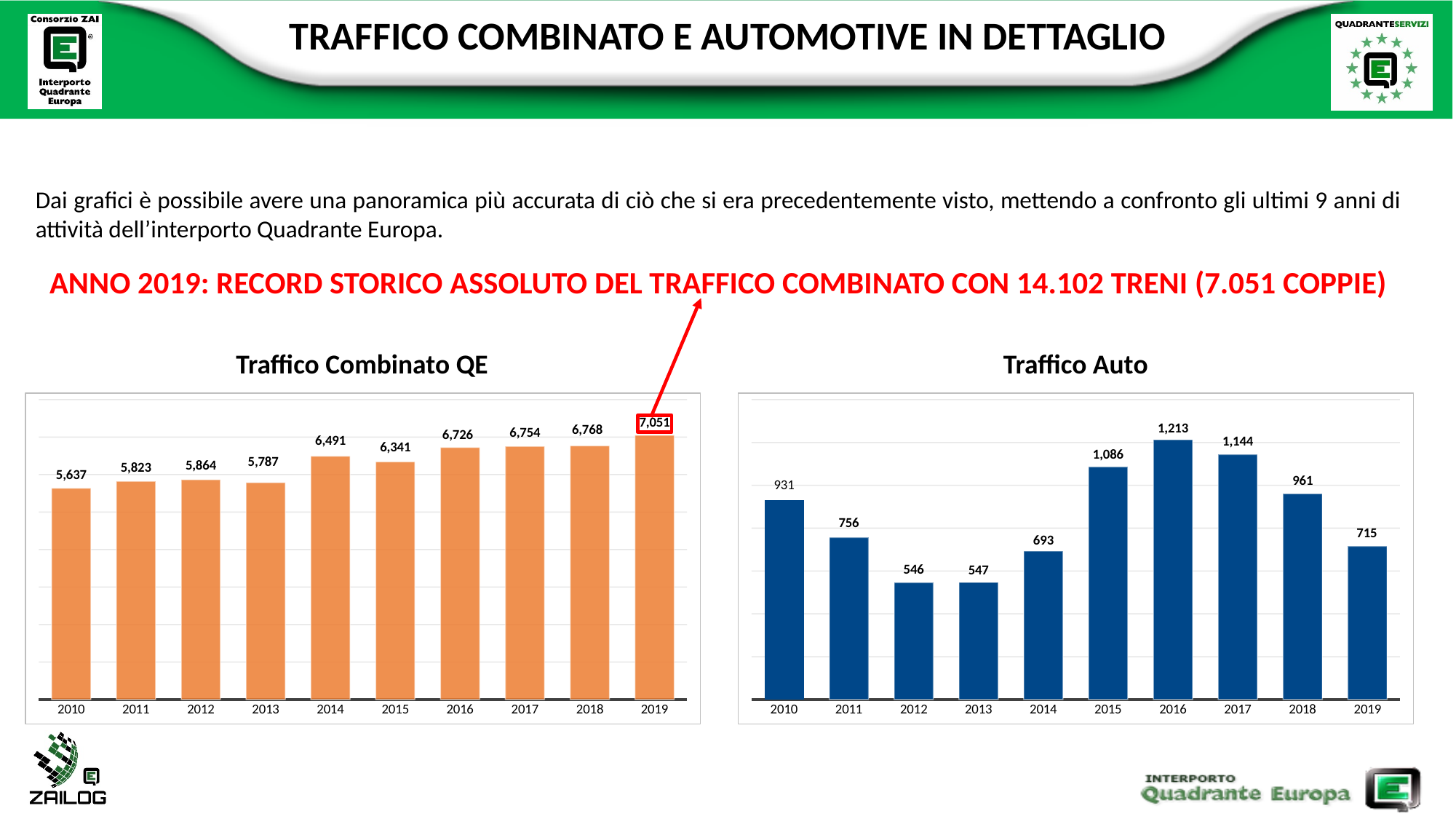
In the 'Traffico Combinato QE' chart, which year has the lowest value? 2010 In the 'Traffico Auto' chart, which year has the lowest value? 2012 What kind of chart is the 'Traffico Auto' chart? bar chart In the 'Traffico Combinato QE' chart, what is the difference between the 2019 value and the 2010 value? 1,414 In the 'Traffico Auto' chart, what is the value for 2016? 1,213 In the 'Traffico Combinato QE' chart, which is larger, the value for 2014 or the value for 2015? 2014 In the 'Traffico Auto' chart, which year has the highest value? 2016 In the 'Traffico Auto' chart, what is the difference between the 2017 value and the 2018 value? 183 In the 'Traffico Auto' chart, do the values rise or fall from 2016 to 2019? fall In the 'Traffico Combinato QE' chart, how many years are shown on the x axis? 10 What colour are the bars in the 'Traffico Combinato QE' chart? orange In the 'Traffico Combinato QE' chart, what is the value for 2019? 7,051